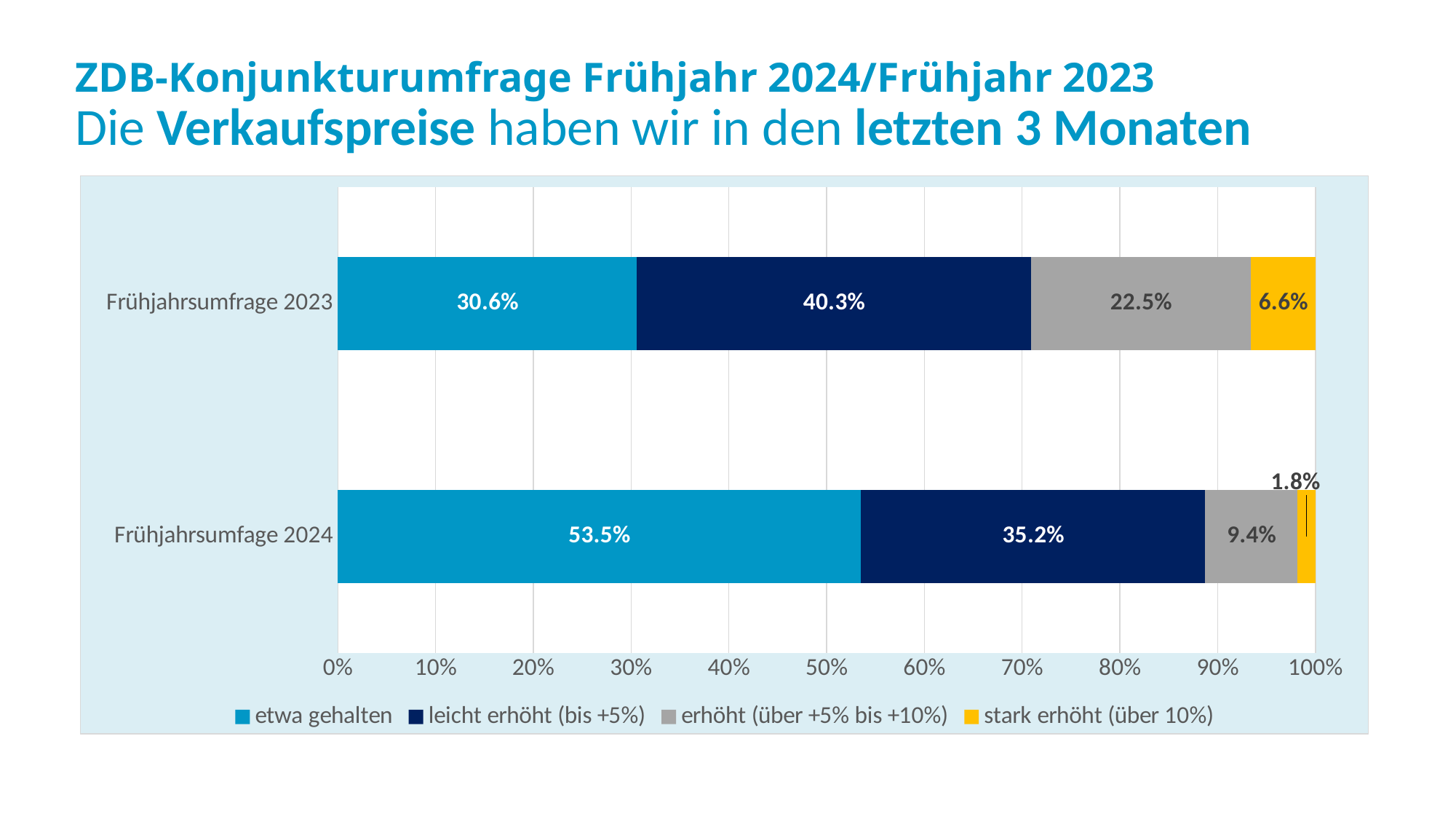
What is the value for "stark erhöht (über 10%)" in the Frühjahrsumfrage 2023? 6.6% What is the difference between the "erhöht (über +5% bis +10%)" shares of the 2023 and 2024 surveys? 13.1 percentage points Which category has the smallest share in the Frühjahrsumfage 2024 bar? stark erhöht (über 10%) What share of respondents in the Frühjahrsumfrage 2023 answered "etwa gehalten"? 30.6% Which category has the largest share in the Frühjahrsumfrage 2023 bar? leicht erhöht (bis +5%) How many series does the legend list? 4 What is the value for "leicht erhöht (bis +5%)" in the Frühjahrsumfage 2024? 35.2% By how many percentage points did the "etwa gehalten" share change from the Frühjahrsumfrage 2023 to the Frühjahrsumfage 2024? 22.9 percentage points How many bars (surveys) are shown in the chart? 2 What is the value for "erhöht (über +5% bis +10%)" in the Frühjahrsumfage 2024? 9.4% What type of chart is shown on the slide? Stacked bar chart Which survey has the higher share for "etwa gehalten"? Frühjahrsumfage 2024